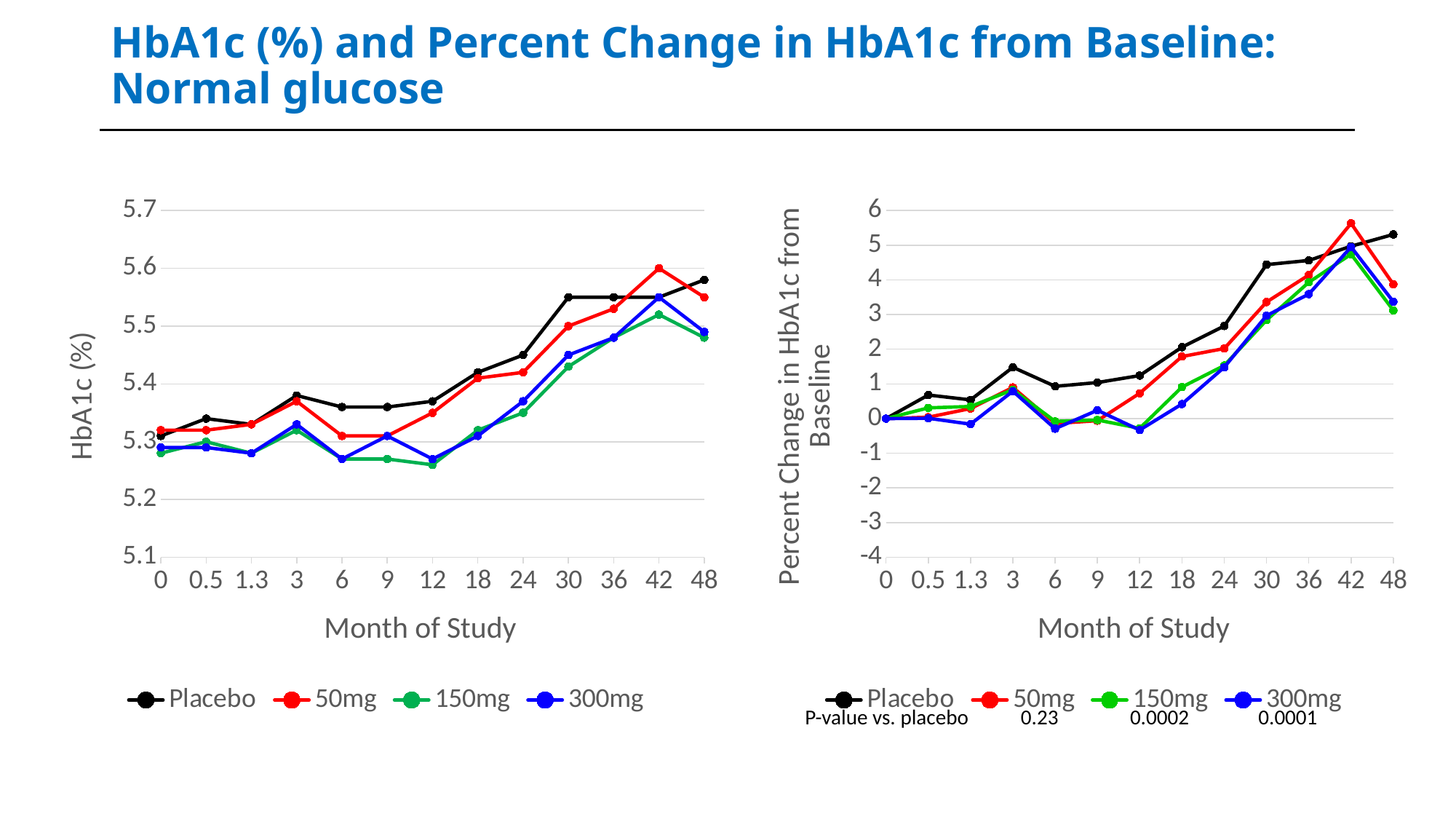
In the left chart (HbA1c (%)), is the value for 150mg at month 12 greater or less than 5.3? less In the right chart (Percent Change in HbA1c from Baseline), which series has the highest value at month 42? 50mg In the left chart (HbA1c (%)), is the value for Placebo at month 48 greater or less than 5.5? greater How many series does the legend of the left chart (HbA1c (%)) list? 4 What kind of chart is the left chart (HbA1c (%))? line chart What P-value vs. placebo is shown for the 300mg group under the right chart? 0.0001 How many month-of-study points are plotted along the x axis of the right chart (Percent Change in HbA1c from Baseline)? 13 In the right chart (Percent Change in HbA1c from Baseline), is the value for 50mg at month 42 greater or less than 5? greater In the right chart (Percent Change in HbA1c from Baseline), what is the value for Placebo at month 0? 0 In the left chart (HbA1c (%)), which is larger at month 48, Placebo or 150mg? Placebo In the right chart (Percent Change in HbA1c from Baseline), does the Placebo series generally rise or fall from month 0 to month 48? rise